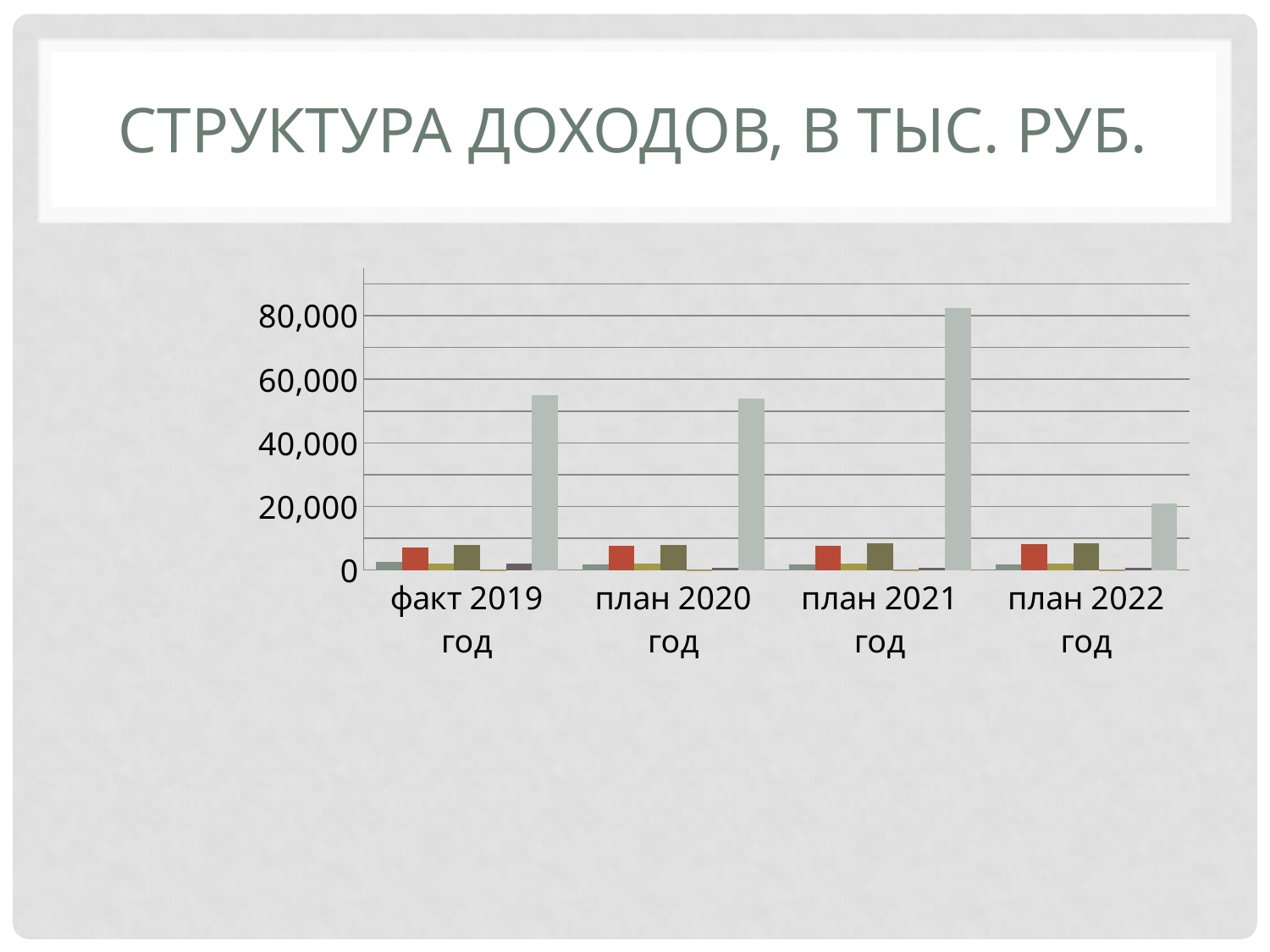
How many categories are shown along the x axis of the chart? 4 What is the title of the chart on the slide? СТРУКТУРА ДОХОДОВ, В ТЫС. РУБ. What is the highest value labelled on the vertical axis of the chart? 80,000 Is the tallest bar for план 2021 год greater or less than 60,000? greater Which has the taller tallest bar: план 2020 год or план 2022 год? план 2020 год Is the tallest bar for план 2022 год greater or less than 40,000? less Which category has the lowest tallest bar in the chart? план 2022 год Is the tallest bar for план 2020 год greater or less than 40,000? greater Which has the taller tallest bar: план 2021 год or факт 2019 год? план 2021 год Which category contains the tallest bar in the chart? план 2021 год What kind of chart is shown on the slide? bar chart